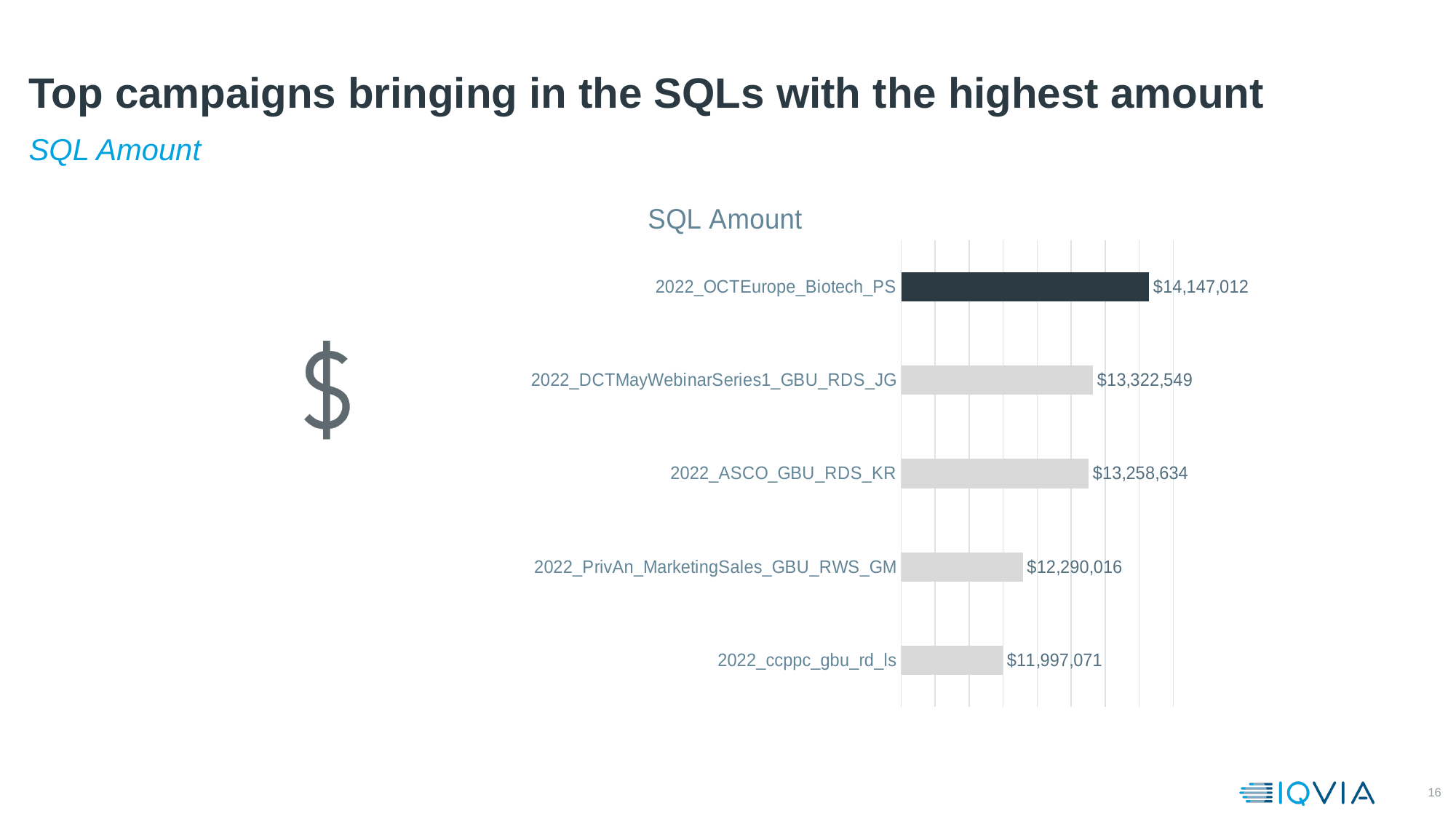
What is the SQL Amount for 2022_OCTEurope_Biotech_PS? $14,147,012 What is the SQL Amount for 2022_ccppc_gbu_rd_ls? $11,997,071 What is the SQL Amount for 2022_PrivAn_MarketingSales_GBU_RWS_GM? $12,290,016 What is the difference in SQL Amount between 2022_OCTEurope_Biotech_PS and 2022_ccppc_gbu_rd_ls? $2,149,941 What is the title of the chart? SQL Amount Which campaign has the highest SQL Amount? 2022_OCTEurope_Biotech_PS What is the difference in SQL Amount between 2022_DCTMayWebinarSeries1_GBU_RDS_JG and 2022_ASCO_GBU_RDS_KR? $63,915 Which has a larger SQL Amount, 2022_PrivAn_MarketingSales_GBU_RWS_GM or 2022_ccppc_gbu_rd_ls? 2022_PrivAn_MarketingSales_GBU_RWS_GM Which campaign has the lowest SQL Amount? 2022_ccppc_gbu_rd_ls What type of chart is shown on the slide? Bar chart What is the SQL Amount for 2022_ASCO_GBU_RDS_KR? $13,258,634 How many campaigns are shown in the chart? 5